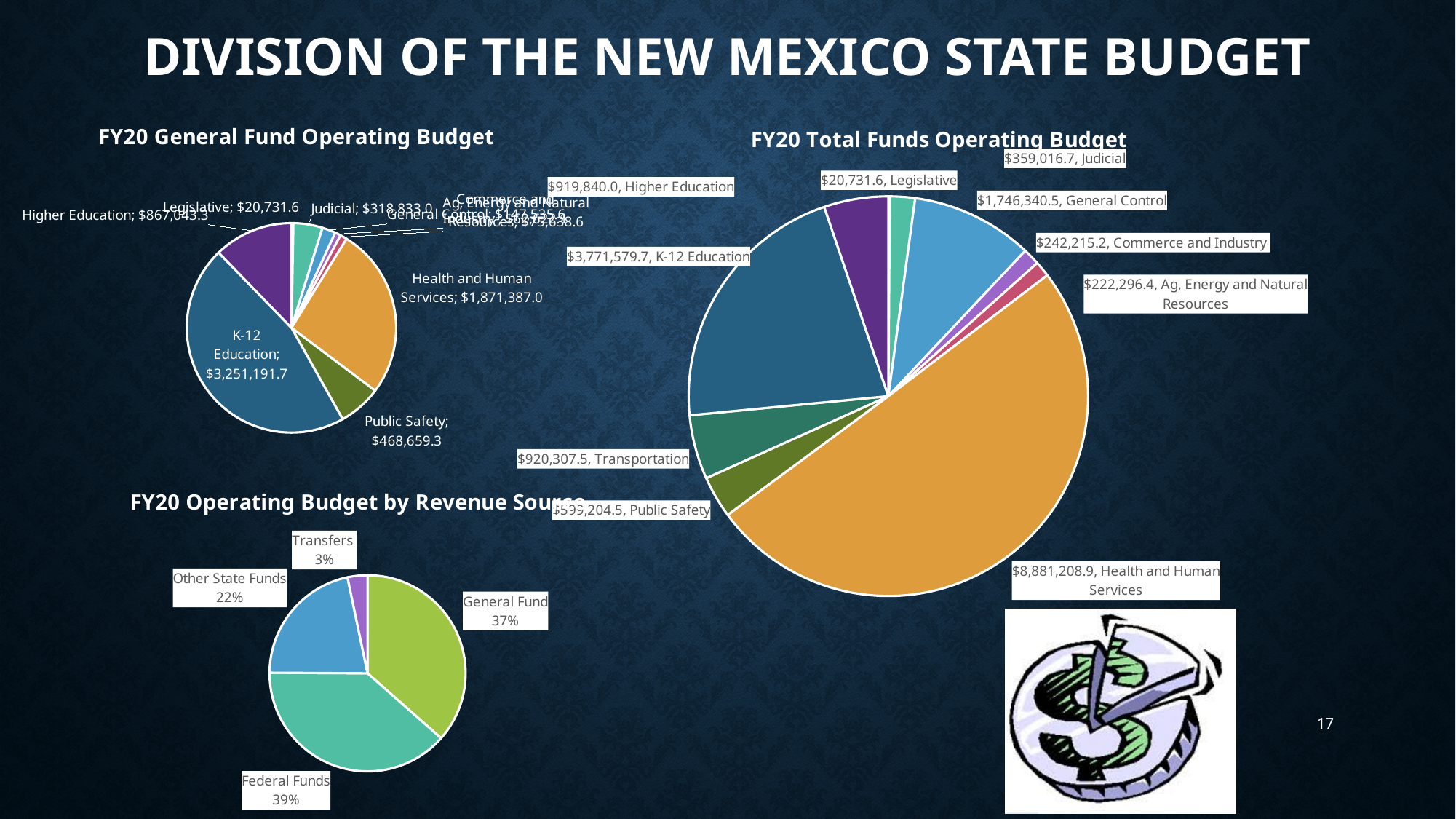
In the FY20 Total Funds Operating Budget chart, what is the value for Health and Human Services? $8,881,208.9 In the FY20 General Fund Operating Budget chart, which is larger, Higher Education or Public Safety? Higher Education In the FY20 Total Funds Operating Budget chart, which category has the largest value? Health and Human Services What kind of chart is the FY20 Total Funds Operating Budget chart? Pie chart In the FY20 Operating Budget by Revenue Source chart, what share comes from Federal Funds? 39% In the FY20 Total Funds Operating Budget chart, what is the difference between Judicial and Commerce and Industry? $116,801.5 In the FY20 Operating Budget by Revenue Source chart, which revenue source has the largest share? Federal Funds In the FY20 Operating Budget by Revenue Source chart, how many revenue sources are shown? 4 In the FY20 General Fund Operating Budget chart, what is the value for K-12 Education? $3,251,191.7 In the FY20 Operating Budget by Revenue Source chart, which revenue source has the smallest share? Transfers In the FY20 Total Funds Operating Budget chart, what is the value for K-12 Education? $3,771,579.7 In the FY20 Operating Budget by Revenue Source chart, how many percentage points larger is Federal Funds than General Fund? 2 percentage points